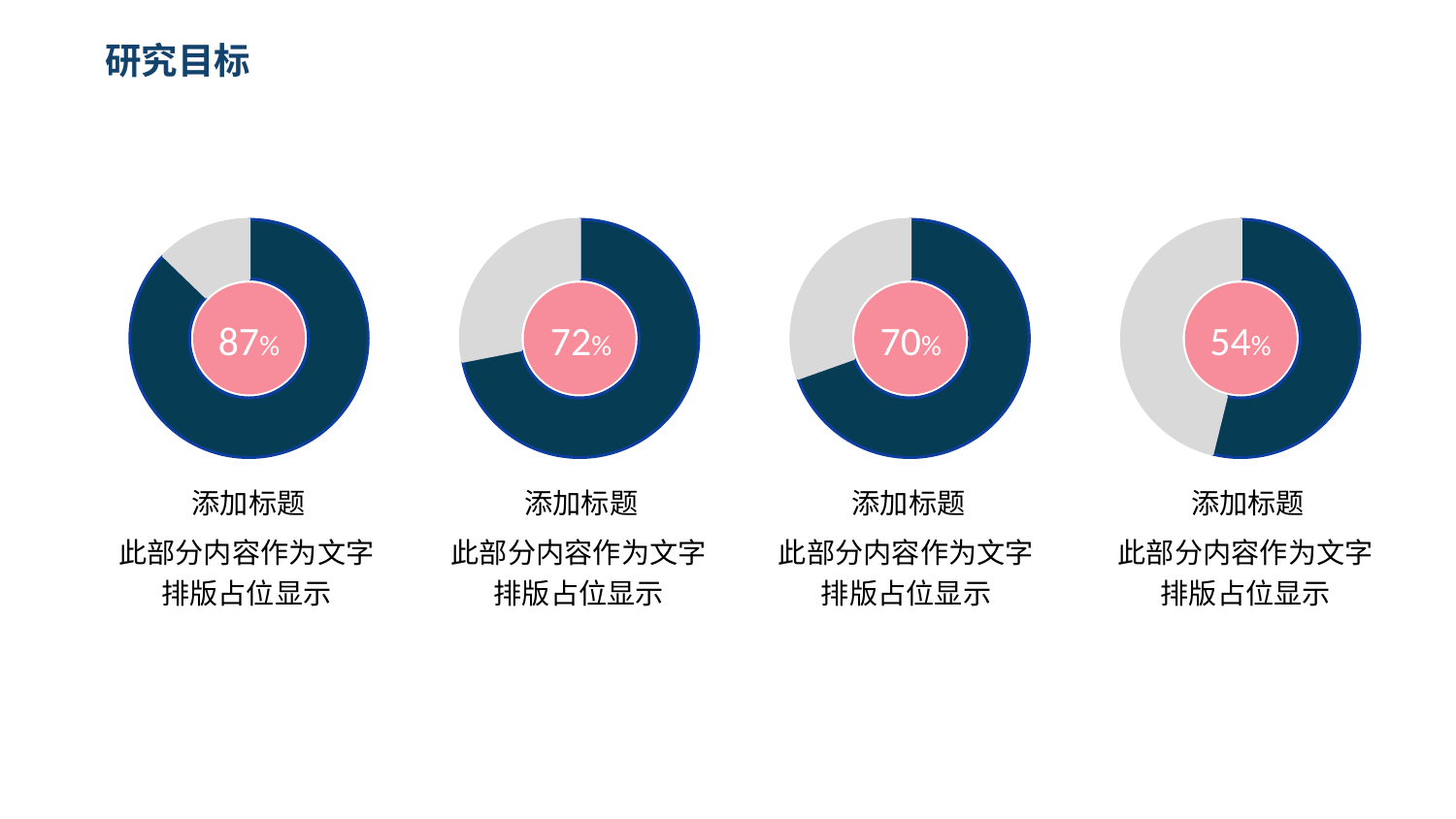
What percentage is shown in the centre of the leftmost donut chart? 87% Which shows a larger percentage, the second donut chart from the left or the rightmost donut chart? The second donut chart from the left (72%) Which of the four donut charts shows the lowest percentage? The rightmost chart (54%) What percentage is shown in the centre of the rightmost donut chart? 54% What is the title of the slide? 研究目标 What is the difference between the percentages shown in the second and third donut charts from the left? 2% What is the difference between the percentage in the leftmost donut chart and the percentage in the rightmost donut chart? 33% What percentage is shown in the centre of the third donut chart from the left? 70% What percentage is shown in the centre of the second donut chart from the left? 72% What kind of chart is used on this slide? Donut (pie) chart Which of the four donut charts shows the highest percentage? The leftmost chart (87%) How many donut charts are on the slide? 4